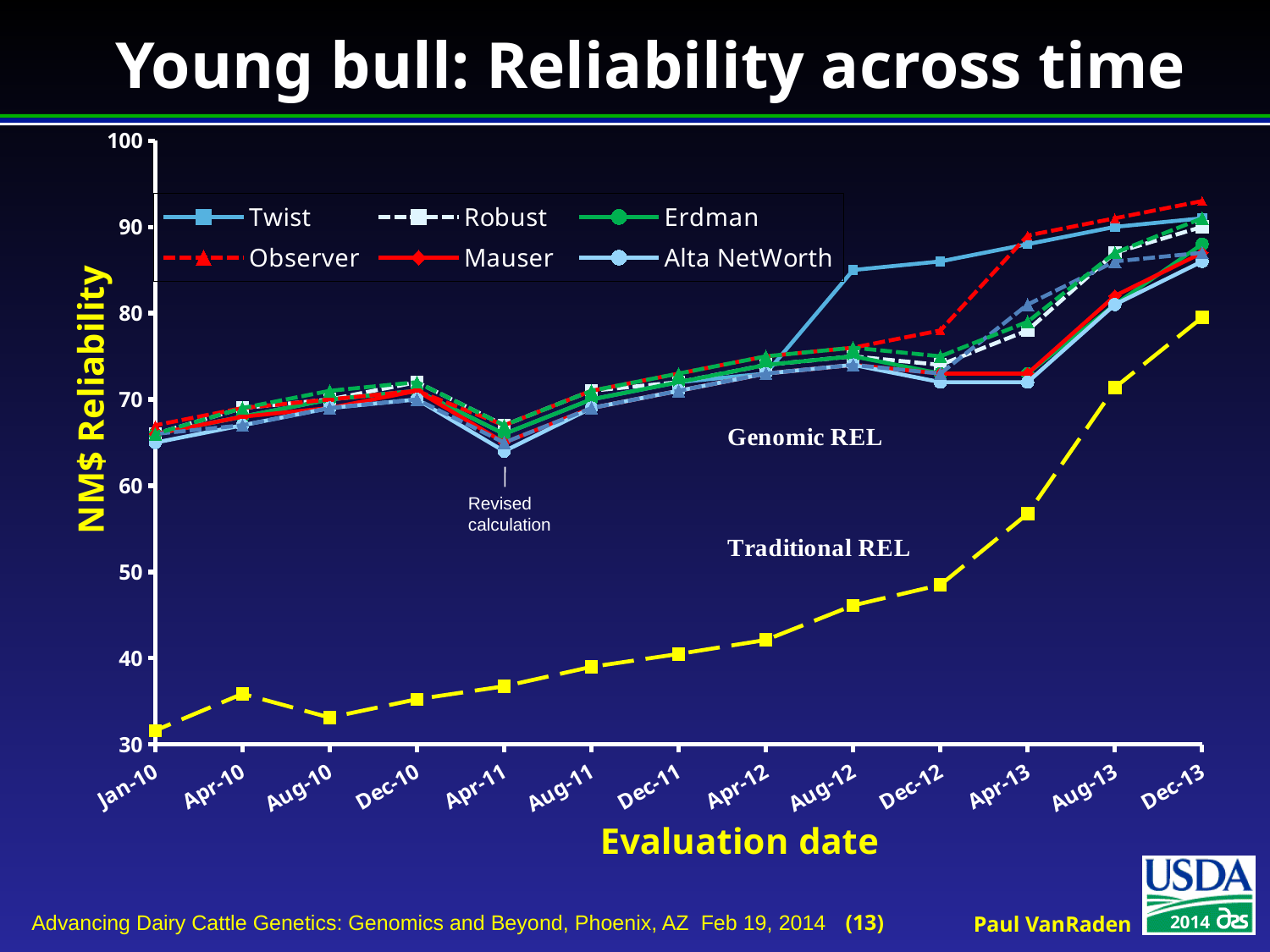
Is the value for Alta NetWorth at Apr-11 greater or less than 70? less Is the Traditional REL value at Jan-10 greater or less than 40? less At Aug-12, which is larger: the value for Twist or the value for Alta NetWorth? Twist How many evaluation dates are labelled on the x axis? 13 Does the Traditional REL line generally rise or fall from Jan-10 to Dec-13? Rise What kind of chart is shown on the slide? Line chart Is the value for Observer at Dec-13 greater or less than 90? greater What is the label of the x axis? Evaluation date What is the label of the y axis? NM$ Reliability How many series does the chart legend list? 6 At Apr-13, which is larger: the value for Observer or the value for Mauser? Observer